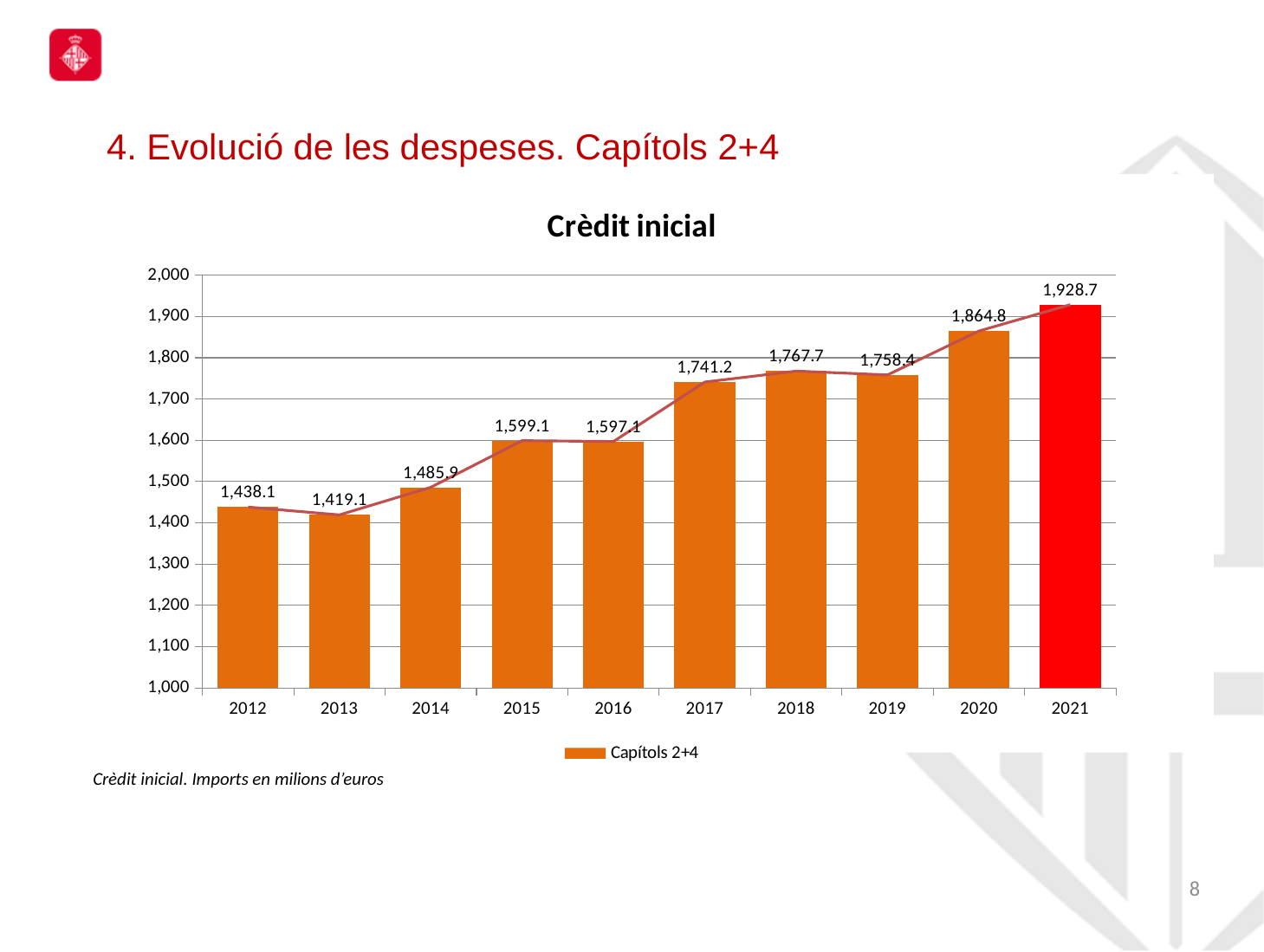
What is the value for 2019 in the Crèdit inicial chart? 1,758.4 What kind of chart is the Crèdit inicial chart? Combination bar and line chart How many years are shown on the x axis of the Crèdit inicial chart? 10 Which is larger in the Crèdit inicial chart, the value for 2018 or the value for 2019? 2018 Which year has the lowest value in the Crèdit inicial chart? 2013 What is the value for 2021 in the Crèdit inicial chart? 1,928.7 What is the difference between the 2012 and 2013 values in the Crèdit inicial chart? 19.0 What is the value for 2015 in the Crèdit inicial chart? 1,599.1 How many series does the legend of the Crèdit inicial chart list? 1 Is the value for 2017 in the Crèdit inicial chart greater or less than 1,700? greater What is the difference between the 2021 and 2020 values in the Crèdit inicial chart? 63.9 Which year has the highest value in the Crèdit inicial chart? 2021